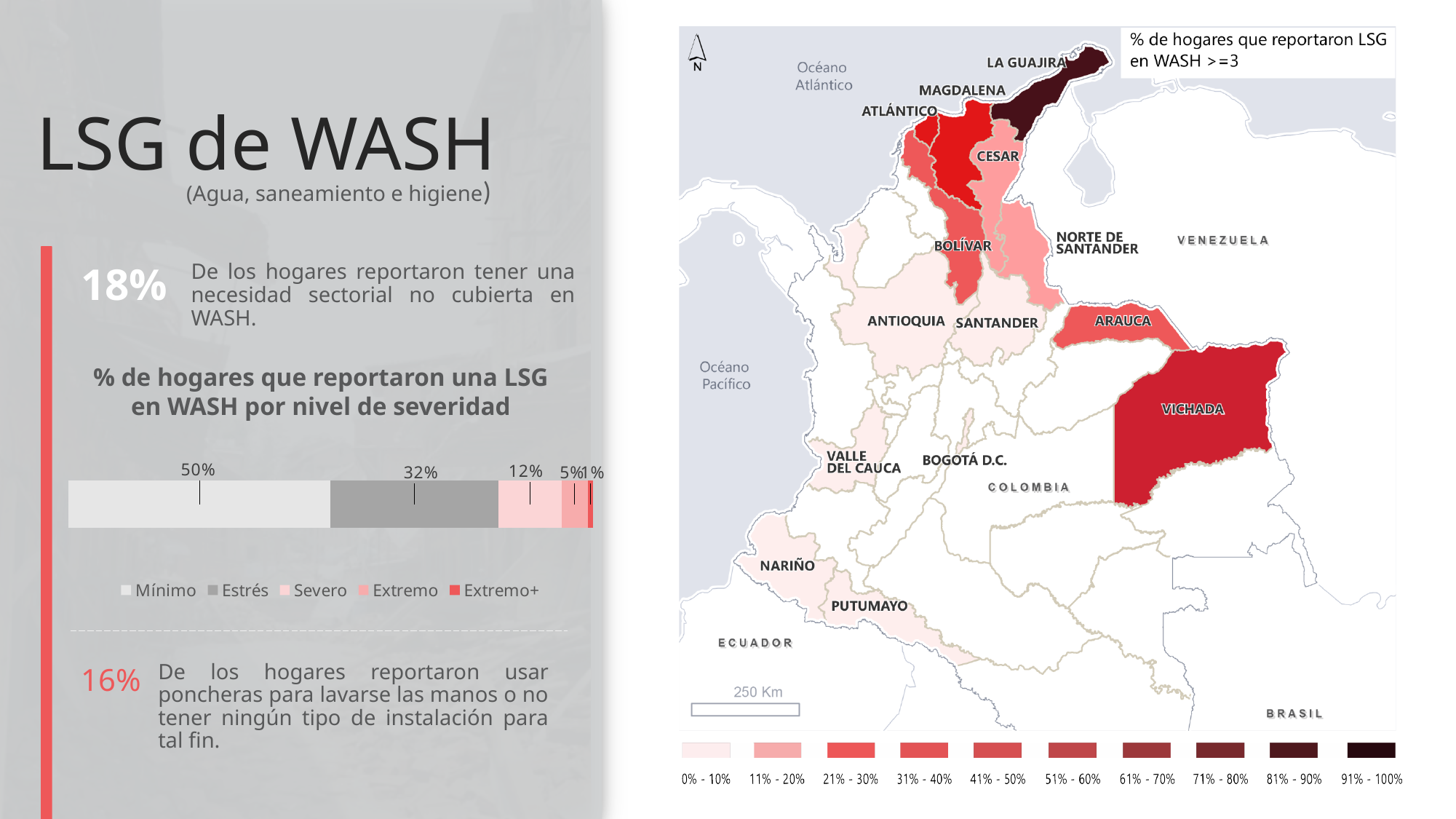
In the chart '% de hogares que reportaron una LSG en WASH por nivel de severidad', what is the total of all the stacked segments? 100% How many series does the legend of the chart '% de hogares que reportaron una LSG en WASH por nivel de severidad' list? 5 In the chart '% de hogares que reportaron una LSG en WASH por nivel de severidad', what is the value for Mínimo? 50% In the chart '% de hogares que reportaron una LSG en WASH por nivel de severidad', which is larger, Severo or Extremo? Severo In the chart '% de hogares que reportaron una LSG en WASH por nivel de severidad', what is the value for Severo? 12% What kind of chart is '% de hogares que reportaron una LSG en WASH por nivel de severidad'? Stacked bar chart In the chart '% de hogares que reportaron una LSG en WASH por nivel de severidad', what is the value for Extremo? 5% In the chart '% de hogares que reportaron una LSG en WASH por nivel de severidad', what is the difference between the Mínimo and Estrés values? 18% In the chart '% de hogares que reportaron una LSG en WASH por nivel de severidad', which severity level has the highest value? Mínimo In the chart '% de hogares que reportaron una LSG en WASH por nivel de severidad', what is the value for Estrés? 32% In the chart '% de hogares que reportaron una LSG en WASH por nivel de severidad', which severity level has the lowest value? Extremo+ In the chart '% de hogares que reportaron una LSG en WASH por nivel de severidad', what is the value for Extremo+? 1%